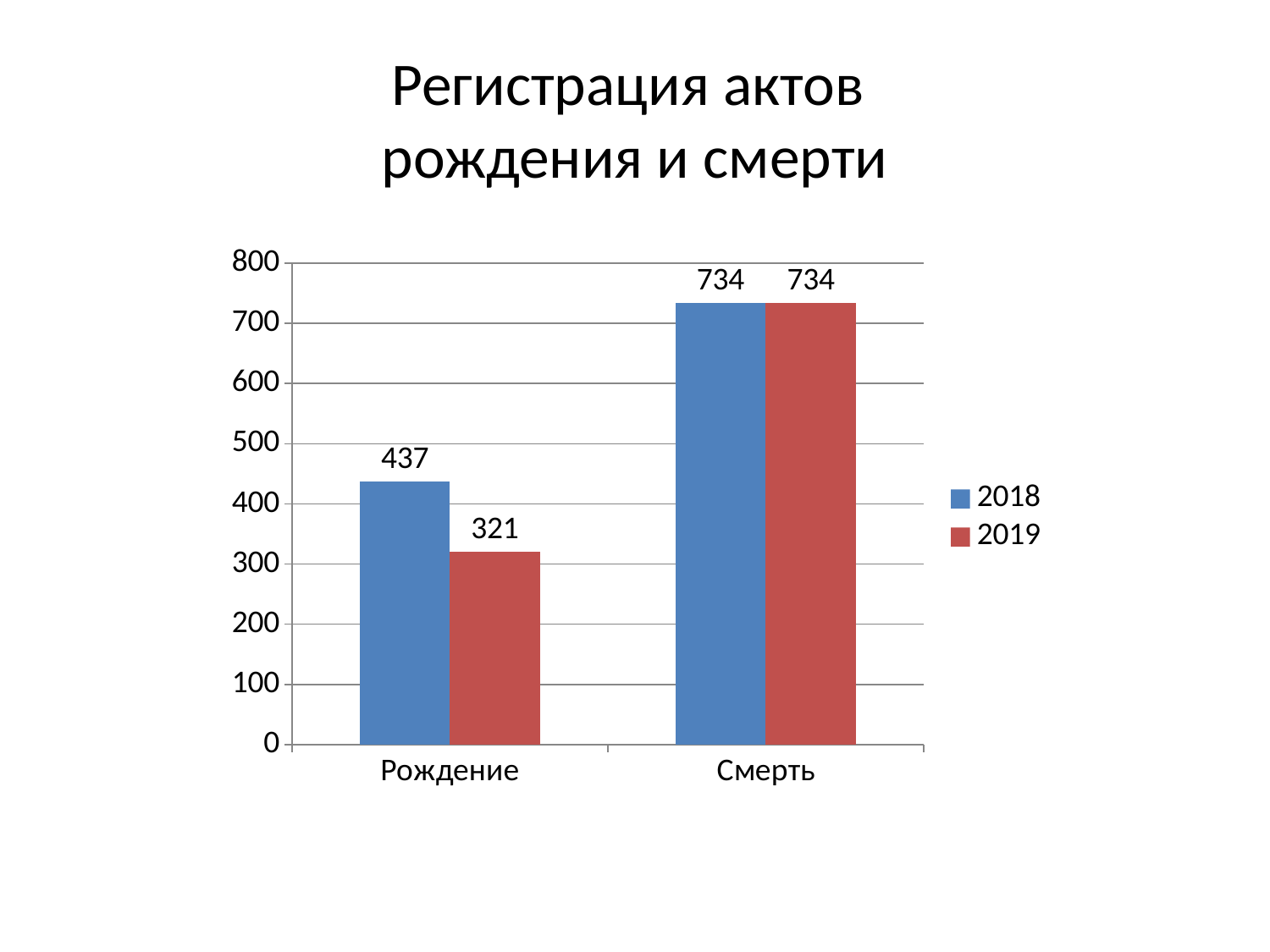
Which category has the highest value in the 2019 series? Смерть Which category has the lowest value in the 2018 series? Рождение What is the value for Рождение in 2018? 437 Which is larger for Рождение: the 2018 value or the 2019 value? 2018 How many categories are shown on the x axis? 2 What is the value for Смерть in 2019? 734 What is the title of the chart on the slide? Регистрация актов рождения и смерти What is the difference between the 2018 and 2019 values for Рождение? 116 What kind of chart is shown on the slide? Bar chart How many series does the legend list? 2 What is the value for Рождение in 2019? 321 What is the value for Смерть in 2018? 734